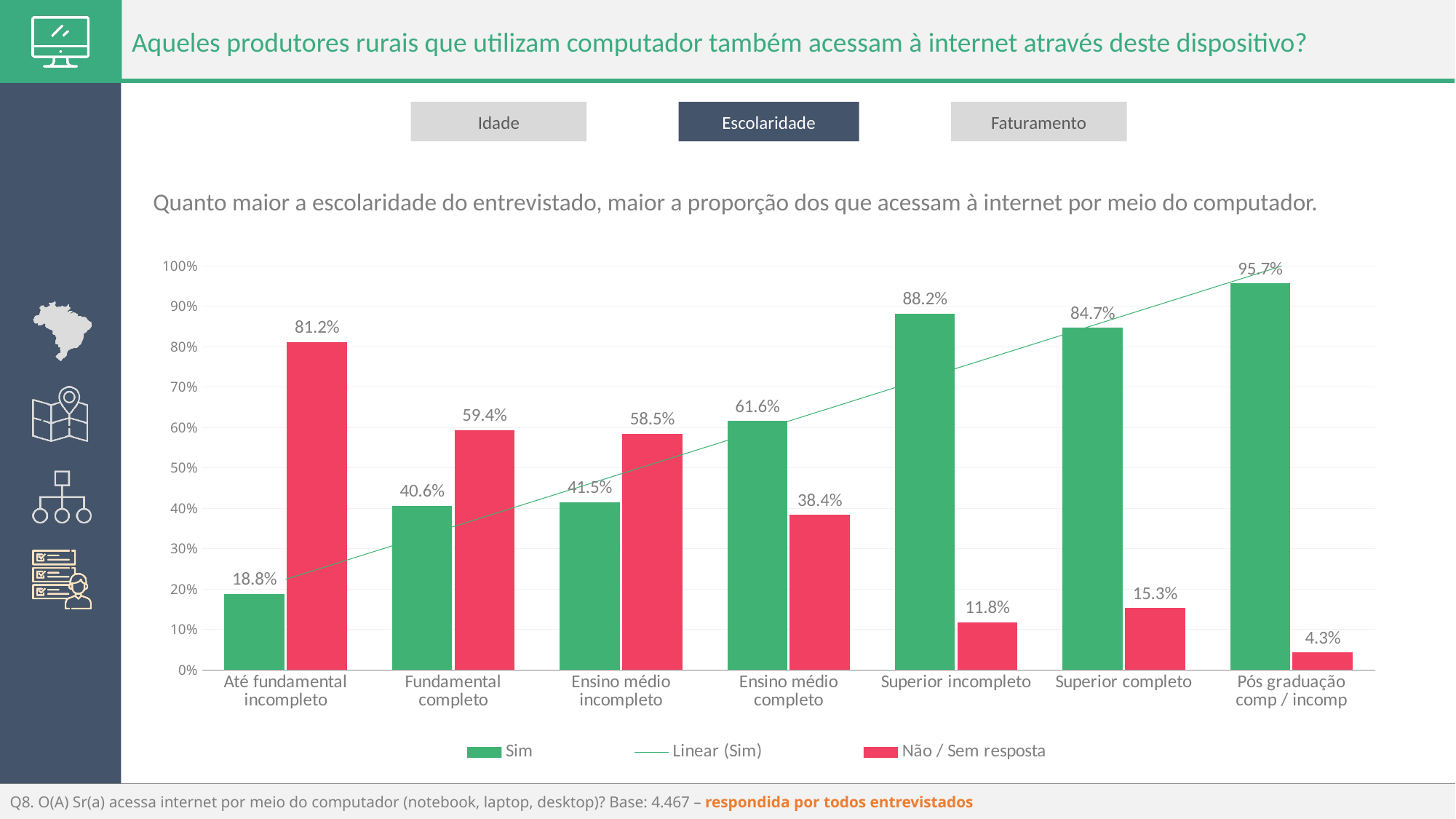
What is the "Sim" value for Superior incompleto? 88.2% How many entries does the legend list? 3 Which category has the highest "Sim" value? Pós graduação comp / incomp What is the "Sim" value for Ensino médio completo? 61.6% What is the difference between the "Sim" values for Superior incompleto and Superior completo? 3.5% Which category has the lowest "Não / Sem resposta" value? Pós graduação comp / incomp What kind of chart is shown on the slide? Bar chart What is the "Não / Sem resposta" value for Até fundamental incompleto? 81.2% Do the "Sim" values generally rise or fall from left to right along the x axis? Rise How many education categories are shown on the x axis? 7 What colour are the "Não / Sem resposta" bars? Red Which is larger: the "Sim" value for Fundamental completo or the "Sim" value for Ensino médio incompleto? Ensino médio incompleto